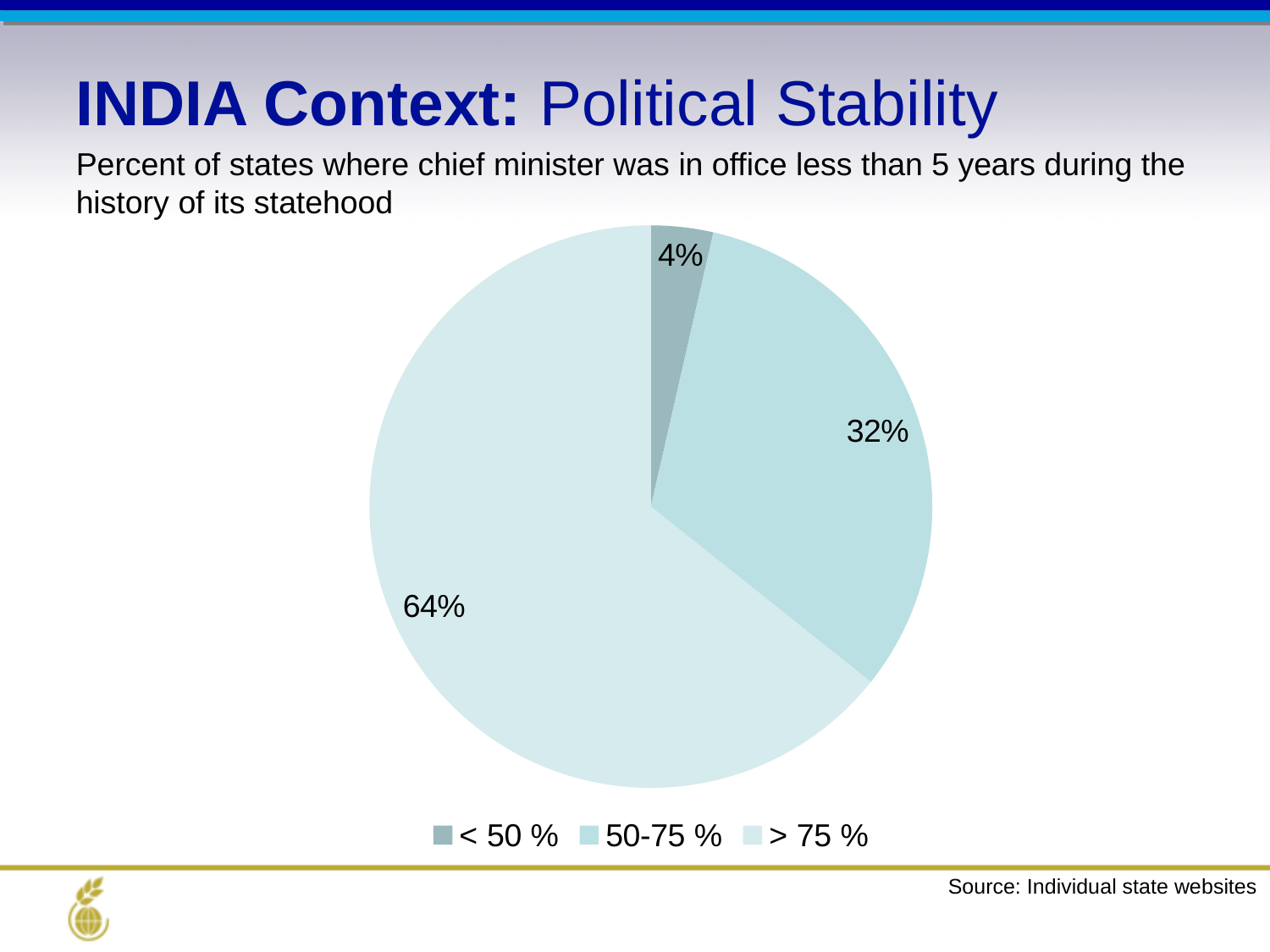
What percentage is shown for the "50-75 %" slice? 32% What source is cited for the chart data? Individual state websites What percentage is shown for the "< 50 %" slice? 4% What is the difference in percentage points between the "> 75 %" slice and the "50-75 %" slice? 32 Which category has the largest slice of the pie? > 75 % What percentage is shown for the "> 75 %" slice? 64% How many slices does the pie chart have? 3 Which slice is larger, "50-75 %" or "< 50 %"? 50-75 % How many entries does the legend list? 3 Which category has the smallest slice of the pie? < 50 % What is the subtitle describing what the chart measures? Percent of states where chief minister was in office less than 5 years during the history of its statehood What type of chart is shown on the slide? pie chart